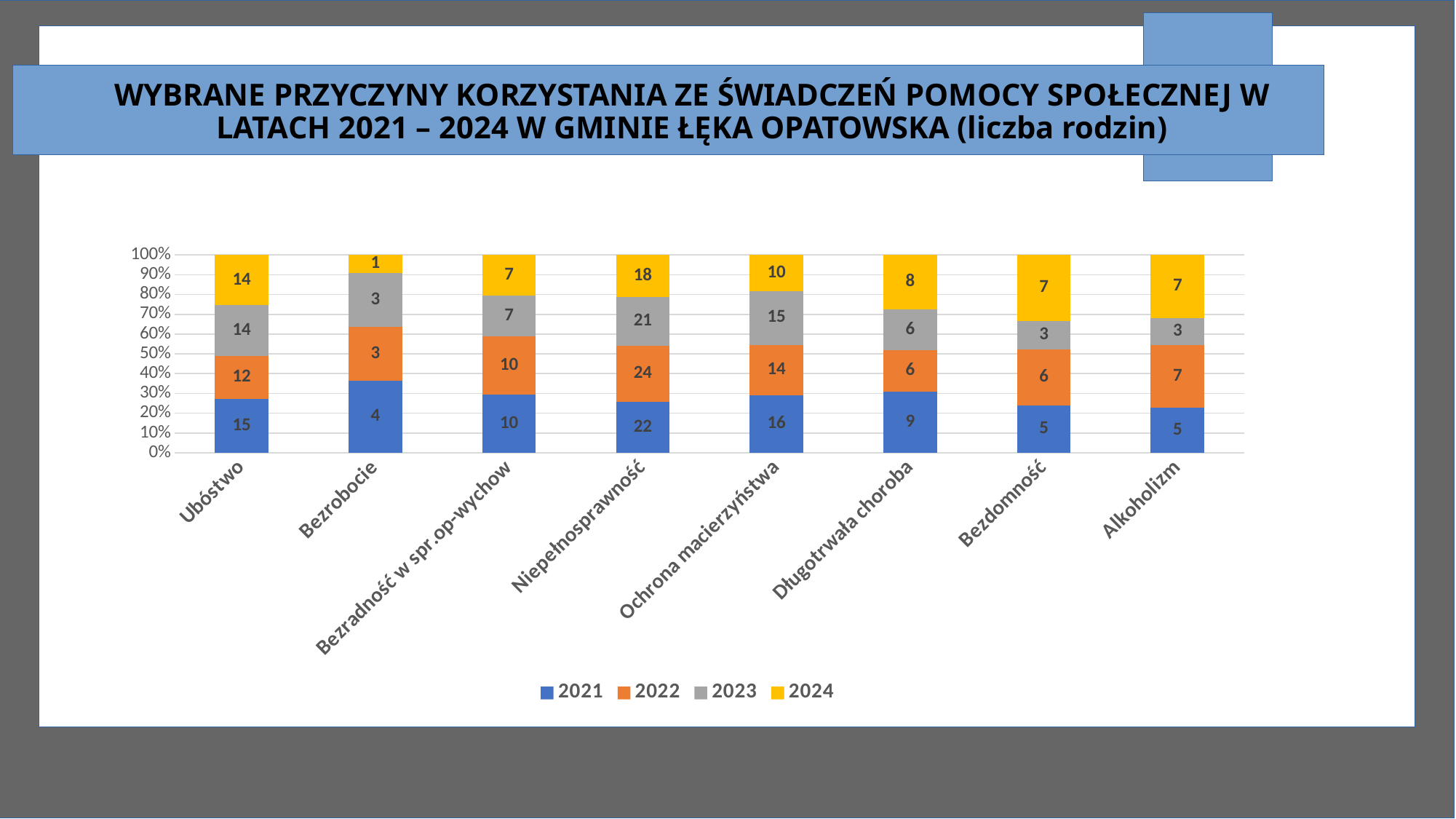
Which category has the lowest value for 2024? Bezrobocie How many categories are shown on the x axis? 8 What is the value for 2024 for Ubóstwo? 14 Which colour represents the 2024 series in the legend? Yellow What is the difference between the 2022 and 2021 values for Niepełnosprawność? 2 Which category has the highest value for 2022? Niepełnosprawność What is the total of the stacked bar for Bezrobocie? 11 Which is larger for Długotrwała choroba: the 2021 value or the 2024 value? 2021 What is the value for 2021 for Niepełnosprawność? 22 What kind of chart is shown on the slide? Stacked bar chart How many series does the legend list? 4 What is the value for 2023 for Ochrona macierzyństwa? 15